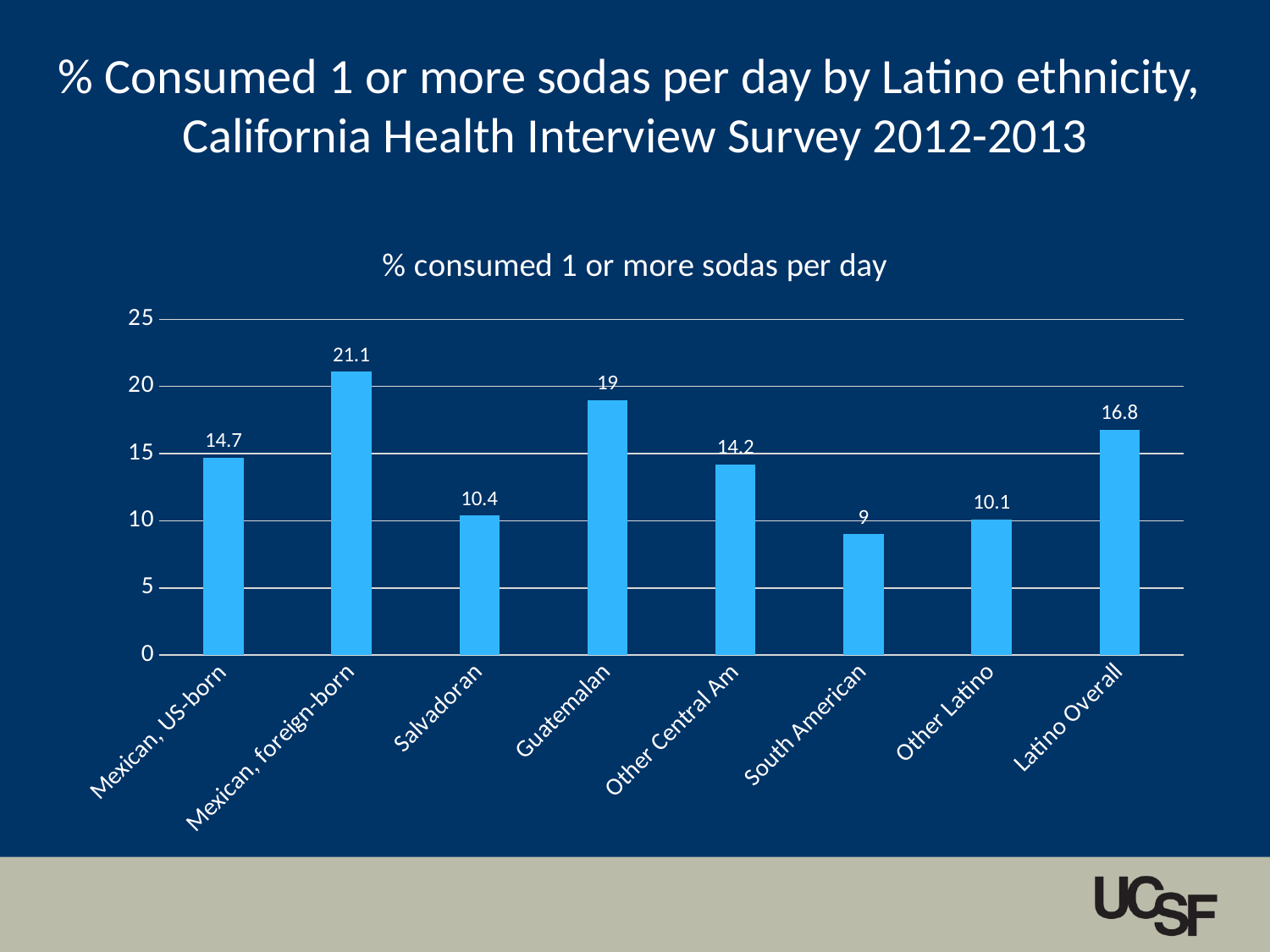
What is the value for Mexican, foreign-born? 21.1 What is the difference between the values for Mexican, foreign-born and Mexican, US-born? 6.4 What is the title of the chart? % consumed 1 or more sodas per day What is the value for Latino Overall? 16.8 Which category has the highest value? Mexican, foreign-born How many categories are shown on the x axis? 8 What is the value for Guatemalan? 19 Which category has the lowest value? South American What is the value for South American? 9 What kind of chart is shown on the slide? bar chart Is the value for Other Latino greater or less than 15? less Which is larger, the value for Salvadoran or the value for Other Central Am? Other Central Am